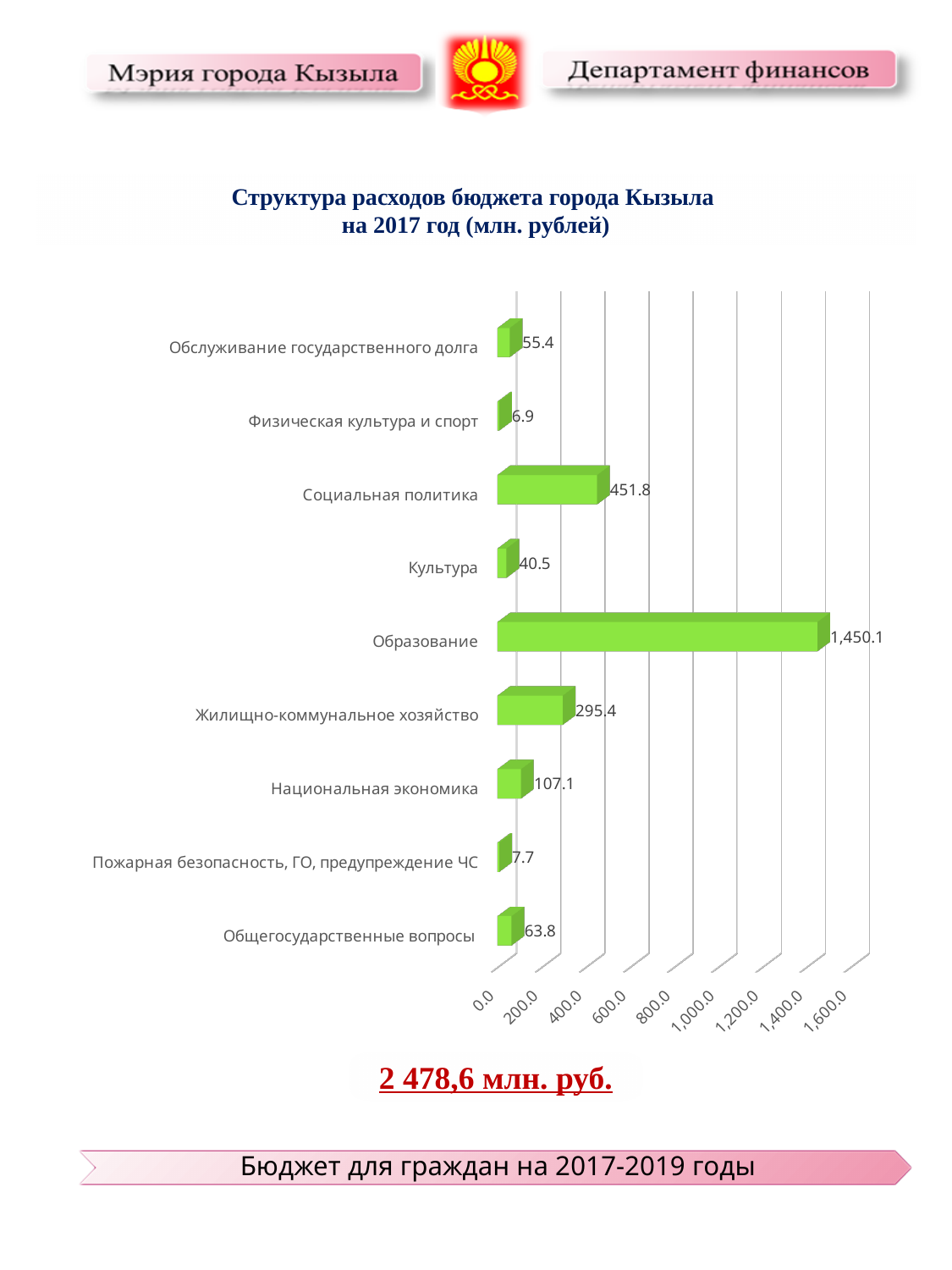
What is the value for Физическая культура и спорт? 6.9 Is the value for Жилищно-коммунальное хозяйство greater or less than 200.0? greater Which category has the lowest value? Физическая культура и спорт Which category has the highest value? Образование How many categories are shown in the chart? 9 What is the value for Образование? 1,450.1 What is the value for Социальная политика? 451.8 Which is larger, the value for Национальная экономика or the value for Общегосударственные вопросы? Национальная экономика What is the value for Жилищно-коммунальное хозяйство? 295.4 What is the title of the chart? Структура расходов бюджета города Кызыла на 2017 год (млн. рублей) What kind of chart is shown on the slide? bar chart What is the difference between the values for Образование and Социальная политика? 998.3